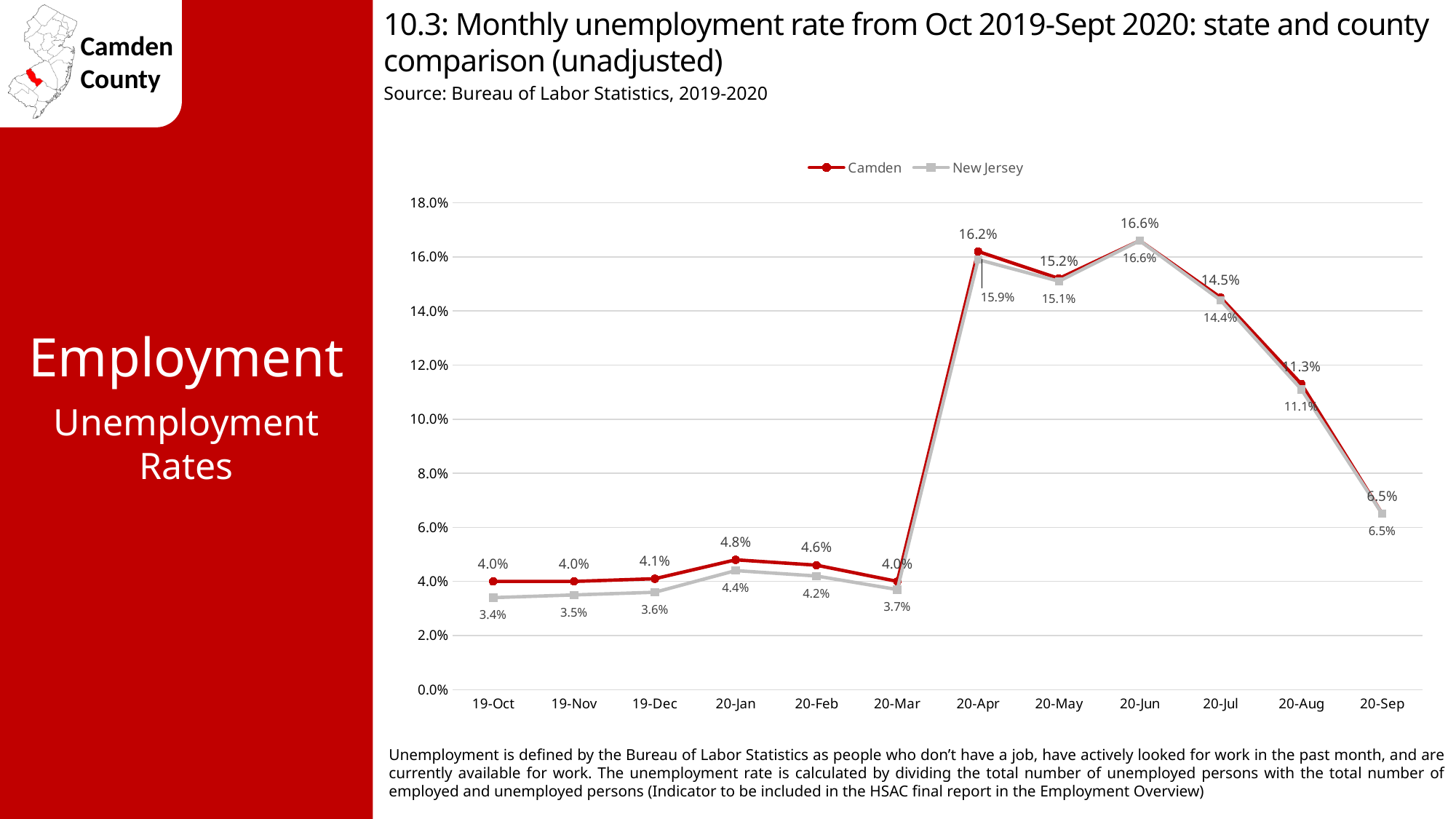
What kind of chart is shown on the slide? Line chart Did the Camden unemployment rate rise or fall from 20-Jun to 20-Sep? Fall What was the Camden unemployment rate in 20-Sep? 6.5% What is the difference between the Camden and New Jersey unemployment rates in 20-Jan? 0.4% How many months are shown on the x axis? 12 In which month was the New Jersey unemployment rate lowest? 19-Oct What was the Camden unemployment rate in 20-Apr? 16.2% Which was higher in 20-Apr, the Camden rate or the New Jersey rate? Camden What was the New Jersey unemployment rate in 19-Oct? 3.4% Is the Camden unemployment rate in 20-Jul greater or less than 14.0%? greater How many series does the legend list? 2 In which month did the Camden unemployment rate reach its highest value? 20-Jun